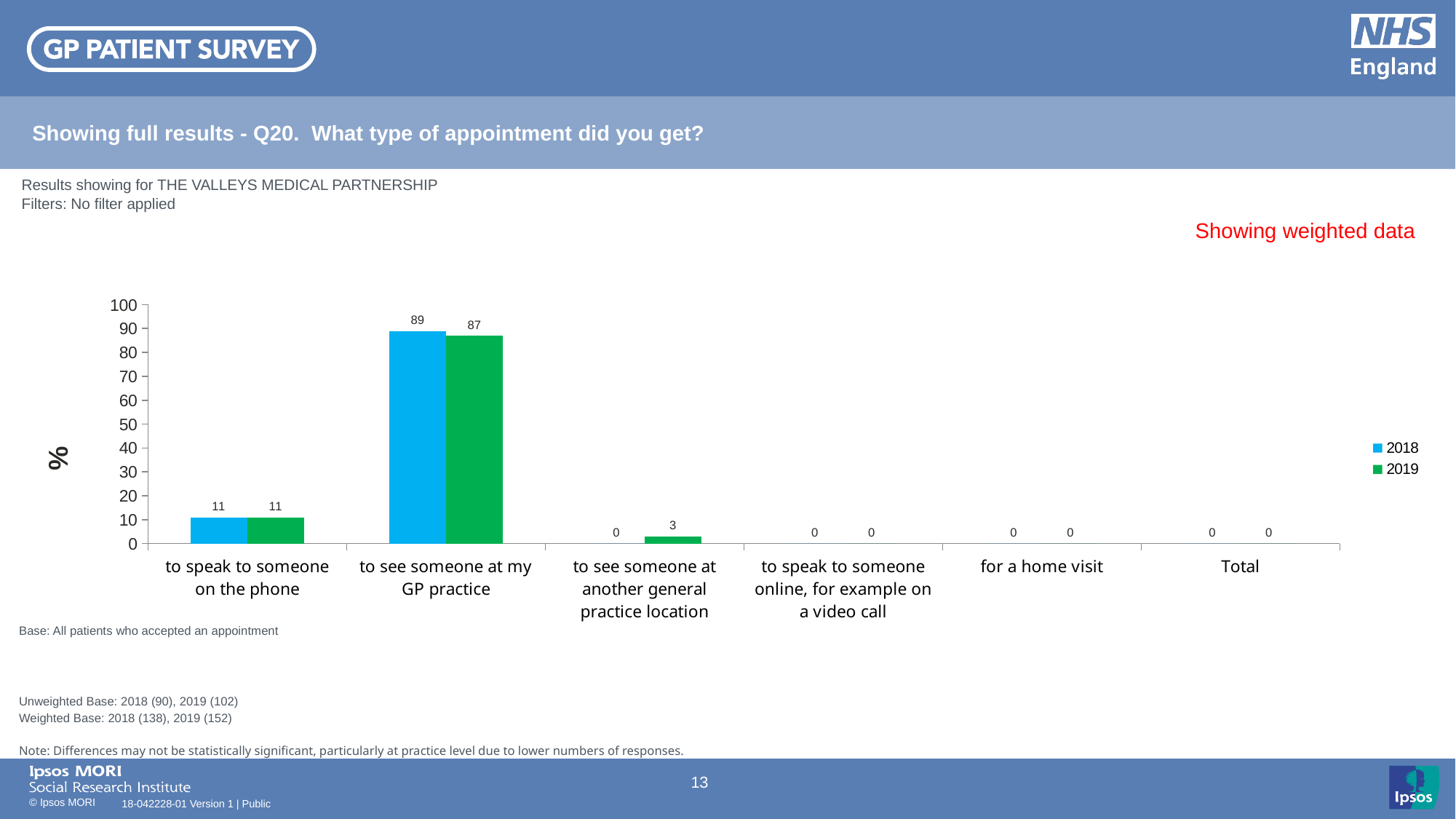
Is the 2018 value for 'to see someone at my GP practice' greater or less than 80? greater What is the label on the y axis? % What is the 2019 value for 'to see someone at my GP practice'? 87 What is the 2019 value for 'to see someone at another general practice location'? 3 What is the 2018 value for 'to speak to someone on the phone'? 11 Which is larger for 'to see someone at my GP practice': the 2018 value or the 2019 value? 2018 What kind of chart is shown on the slide? bar chart How many categories are shown on the x axis? 6 How many series does the legend list? 2 Which category has the highest 2019 value? to see someone at my GP practice What is the difference between the 2018 and 2019 values for 'to see someone at my GP practice'? 2 What is the 2018 value for 'to see someone at my GP practice'? 89